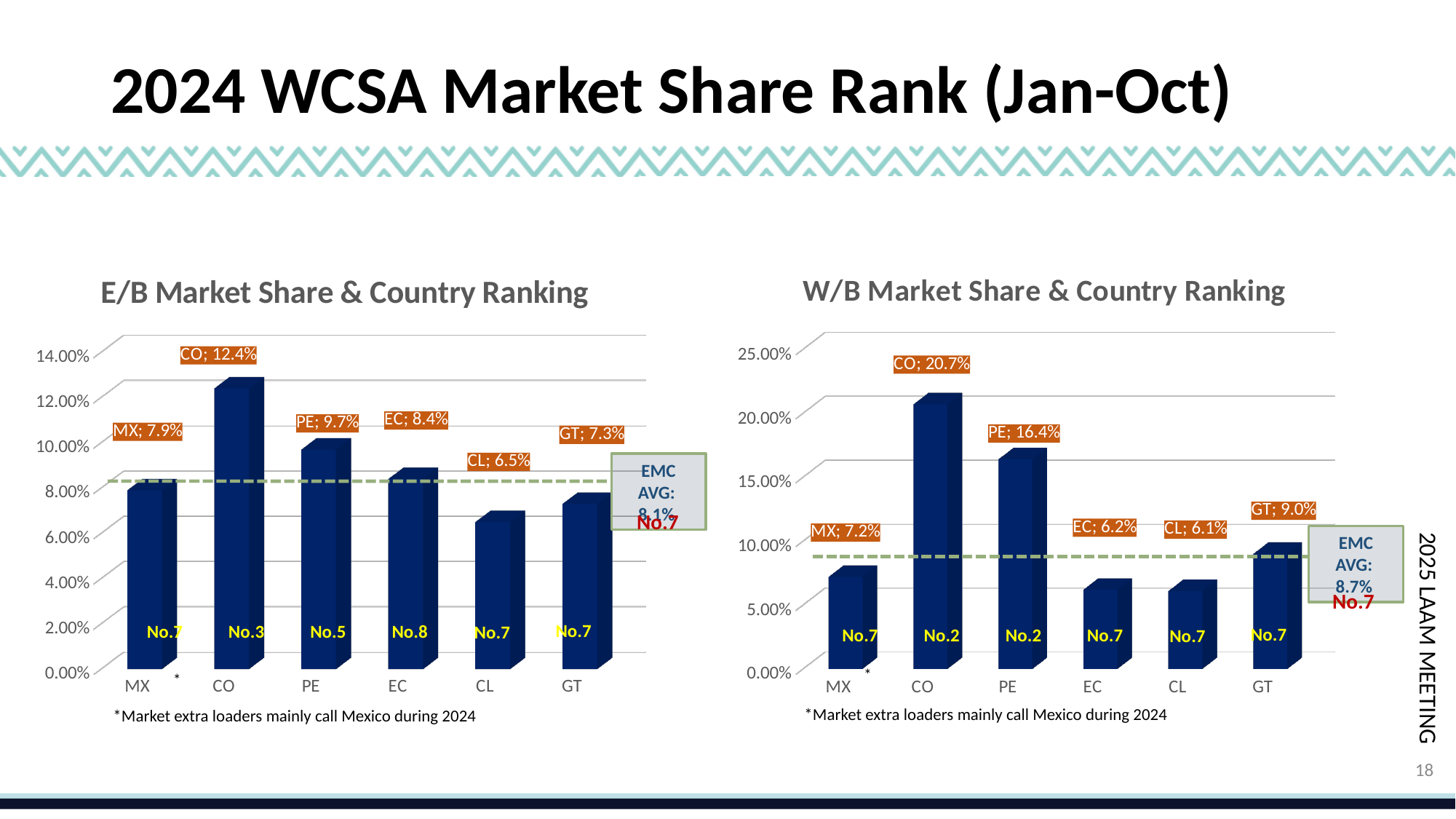
In the E/B Market Share & Country Ranking chart, which country has the lowest market share? CL In the E/B Market Share & Country Ranking chart, what is the market share for CO? 12.4% In the W/B Market Share & Country Ranking chart, is the value for GT greater or less than 10.00%? less In the E/B Market Share & Country Ranking chart, what country ranking is shown for CO? No.3 In the E/B Market Share & Country Ranking chart, what is the difference between the market shares of CO and MX? 4.5% In the W/B Market Share & Country Ranking chart, what is the EMC AVG value shown? 8.7% How many countries are shown in the E/B Market Share & Country Ranking chart? 6 What type of chart is the W/B Market Share & Country Ranking chart? Bar chart In the W/B Market Share & Country Ranking chart, which country has the highest market share? CO In the W/B Market Share & Country Ranking chart, what is the market share for PE? 16.4% In the E/B Market Share & Country Ranking chart, which has a larger market share, PE or EC? PE In the W/B Market Share & Country Ranking chart, what is the difference between the market shares of CO and PE? 4.3%